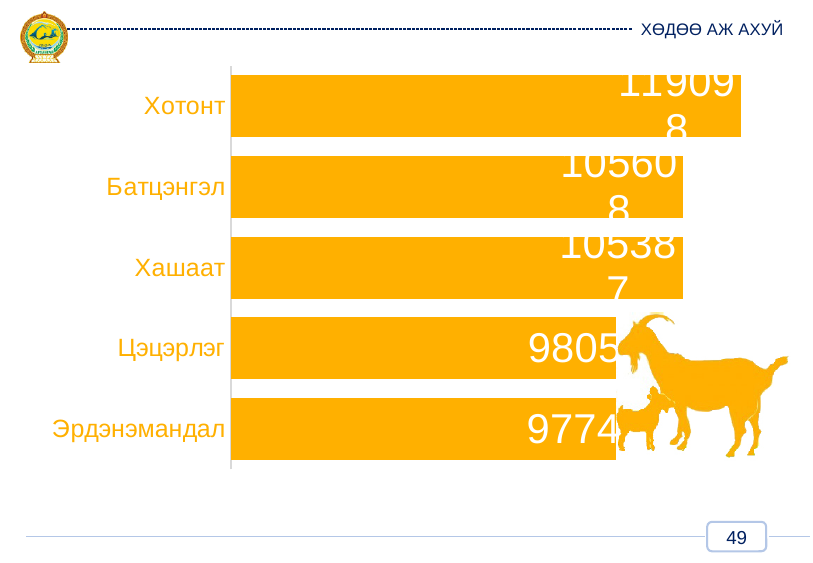
What is the difference between the values for Батцэнгэл and Хашаат? 221 What type of chart is shown on the slide? bar chart What is the value for Батцэнгэл? 105608 What is the value for Хотонт? 119098 Which is larger, the value for Хотонт or the value for Цэцэрлэг? Хотонт Do the bar lengths increase or decrease from the top of the chart to the bottom? decrease How many categories are shown in the bar chart? 5 Which category has the highest value? Хотонт What is the value for Хашаат? 105387 What is the difference between the values for Хотонт and Батцэнгэл? 13490 Which is larger, the value for Хашаат or the value for Эрдэнэмандал? Хашаат What colour are the bars in the chart? orange